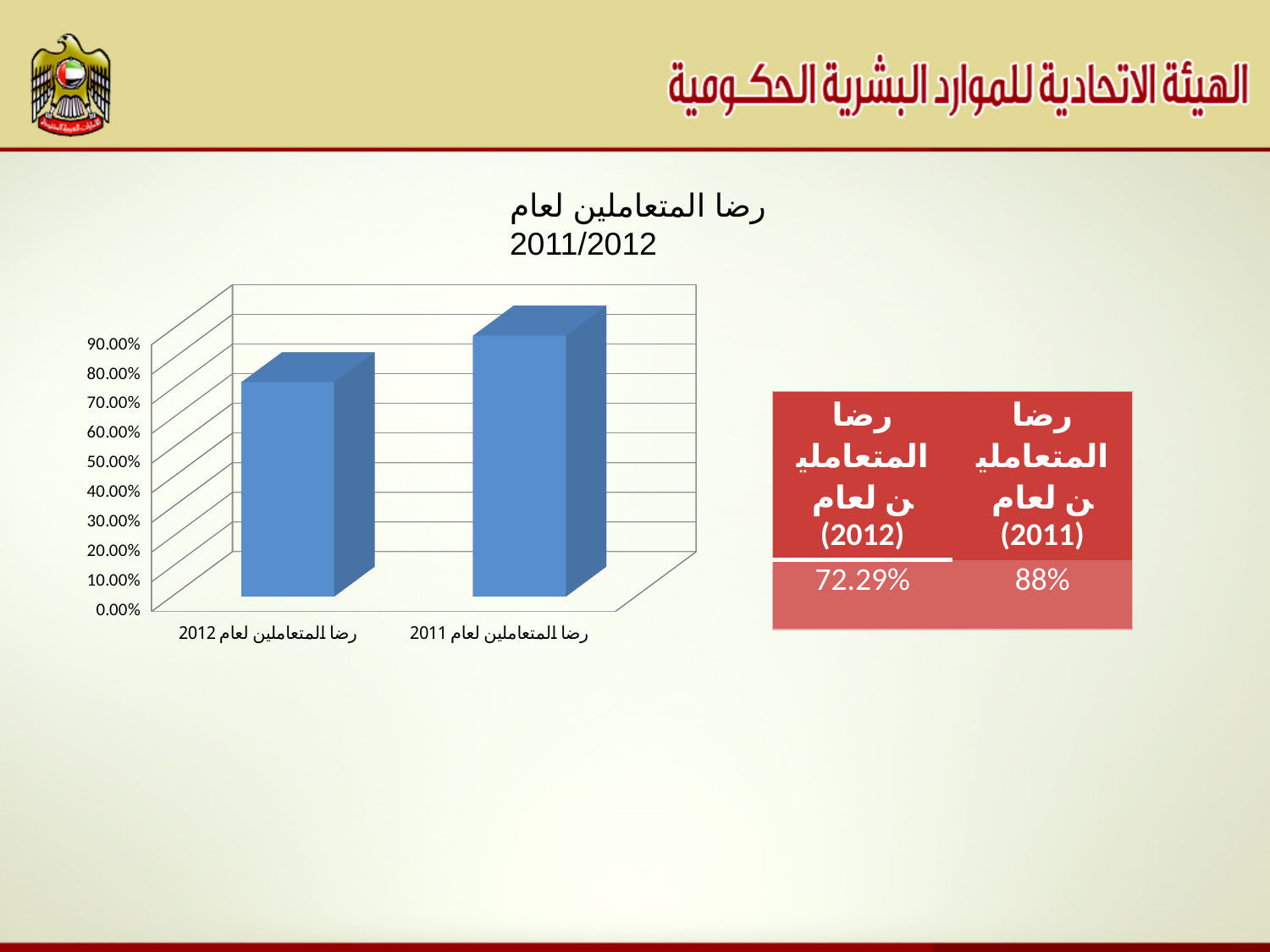
Which year has the higher customer satisfaction value? 2011 Is the value for 2012 (رضا المتعاملين لعام 2012) greater or less than 80.00%? less What is the title of the chart? رضا المتعاملين لعام 2011/2012 What is the difference between the 2011 and 2012 customer satisfaction values? 15.71% What is the highest value labelled on the vertical axis? 90.00% Is the value for 2011 (رضا المتعاملين لعام 2011) greater or less than 80.00%? greater What is the customer satisfaction value for 2011 (رضا المتعاملين لعام 2011)? 88% What type of chart is shown on the slide? bar chart Which year has the lower customer satisfaction value? 2012 How many bars (categories) does the chart show? 2 Is the bar for 2011 larger or smaller than the bar for 2012? larger What is the customer satisfaction value for 2012 (رضا المتعاملين لعام 2012)? 72.29%